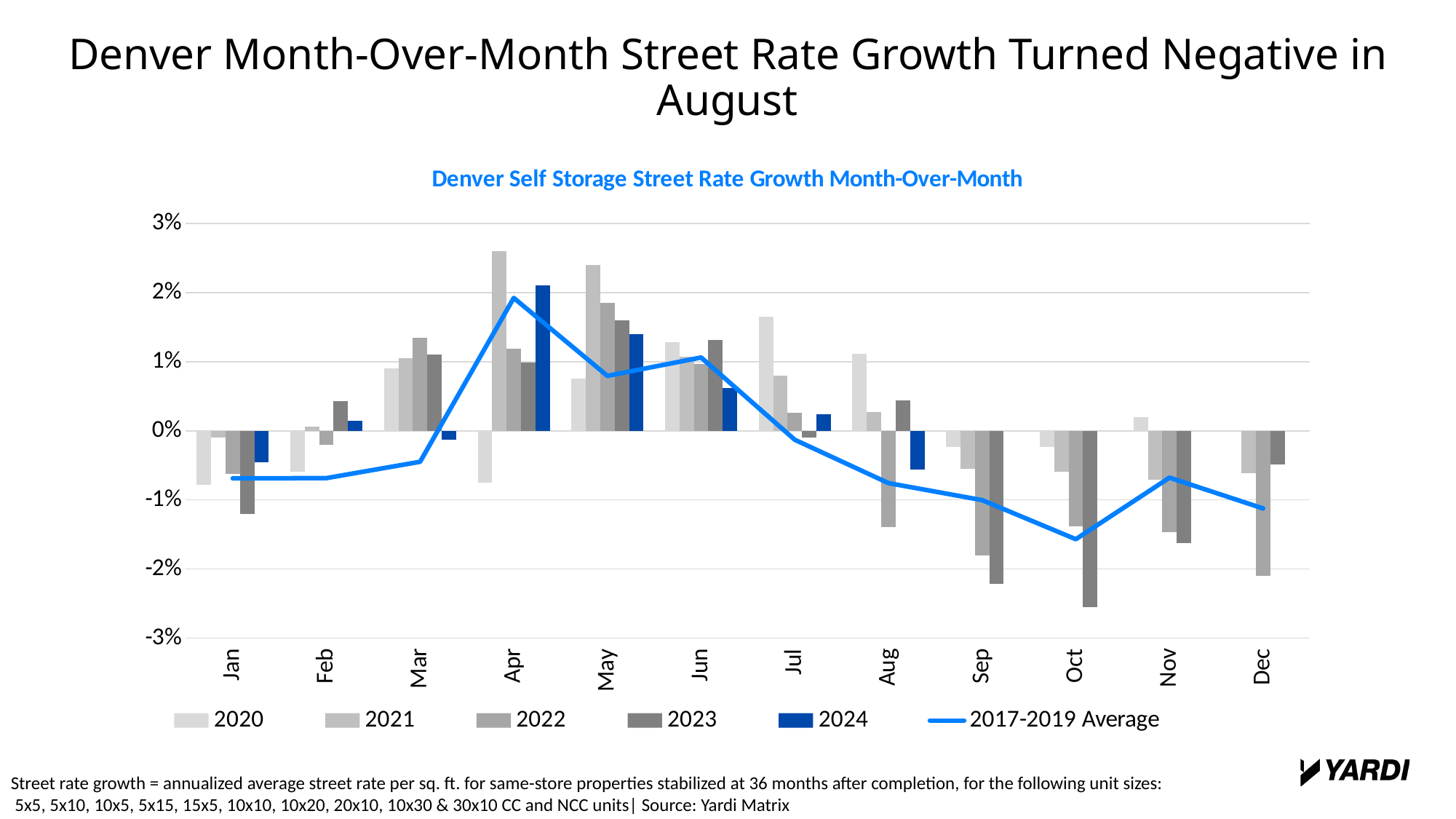
How many series does the legend list? 6 In which month is the 2021 value highest? Apr How many months are shown on the x axis? 12 Which series is drawn as a line rather than bars? 2017-2019 Average In which month is the 2024 value highest? Apr Is the 2024 value for Aug greater or less than 0%? less Which is larger, the 2024 value for Apr or the 2024 value for May? Apr Is the 2024 value for Apr greater or less than 1%? greater Is the 2023 value for Oct greater or less than -2%? less Does the 2017-2019 Average line rise or fall from Apr to Oct? fall In which month is the 2023 value lowest? Oct What is the title of the chart? Denver Self Storage Street Rate Growth Month-Over-Month